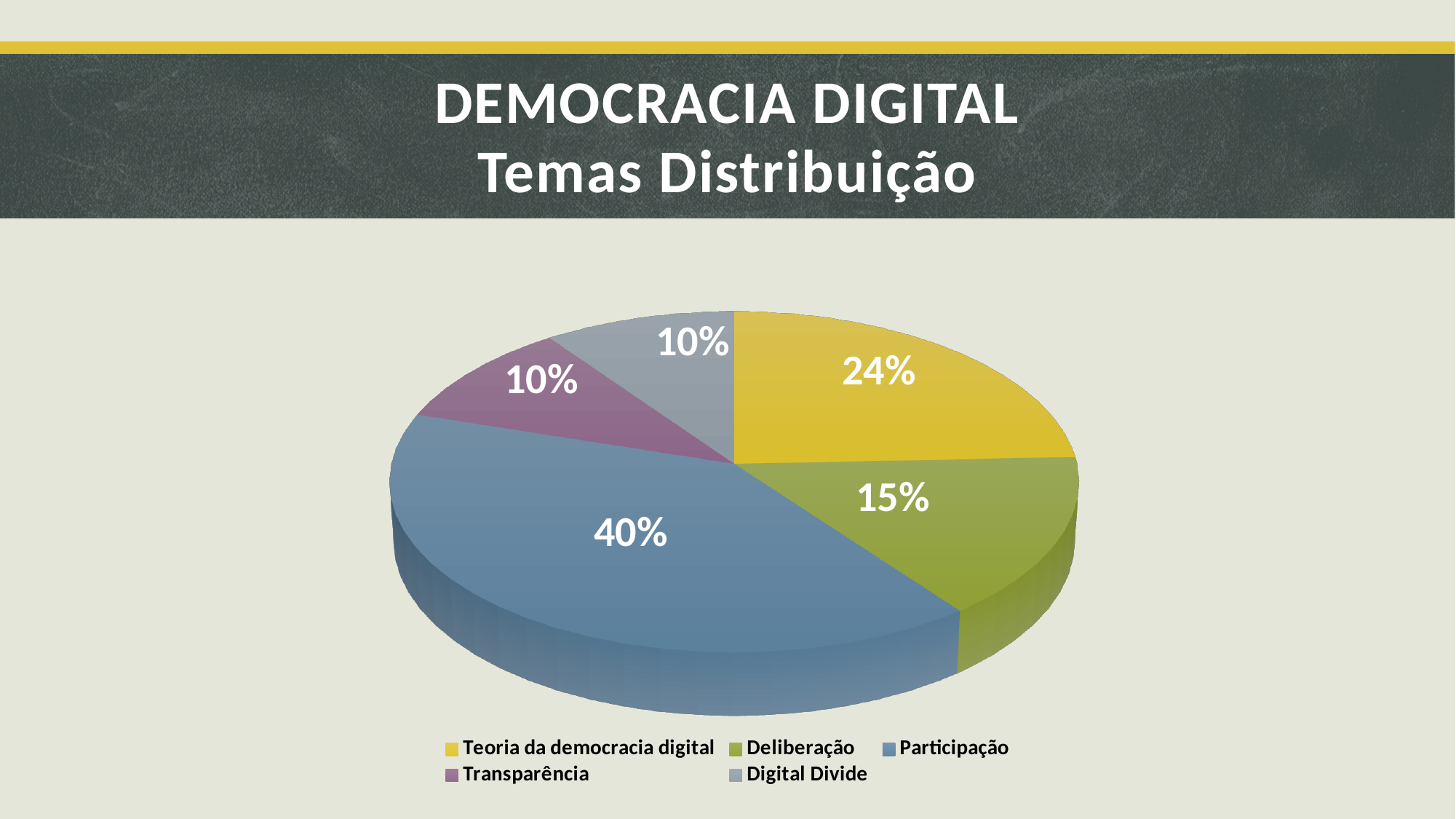
How many slices does the pie chart have? 5 What is the title of the chart on the slide? DEMOCRACIA DIGITAL Temas Distribuição What kind of chart is shown on the slide? Pie chart What is the difference in percentage points between Participação and Teoria da democracia digital? 16 What share of the pie does Transparência have? 10% Which is larger, the slice for Deliberação or the slice for Teoria da democracia digital? Teoria da democracia digital What share of the pie does Deliberação have? 15% Which category has the largest slice of the pie? Participação What share of the pie does Digital Divide have? 10% What share of the pie does Teoria da democracia digital have? 24% What share of the pie does Participação have? 40% What colour is the slice for Participação? Blue